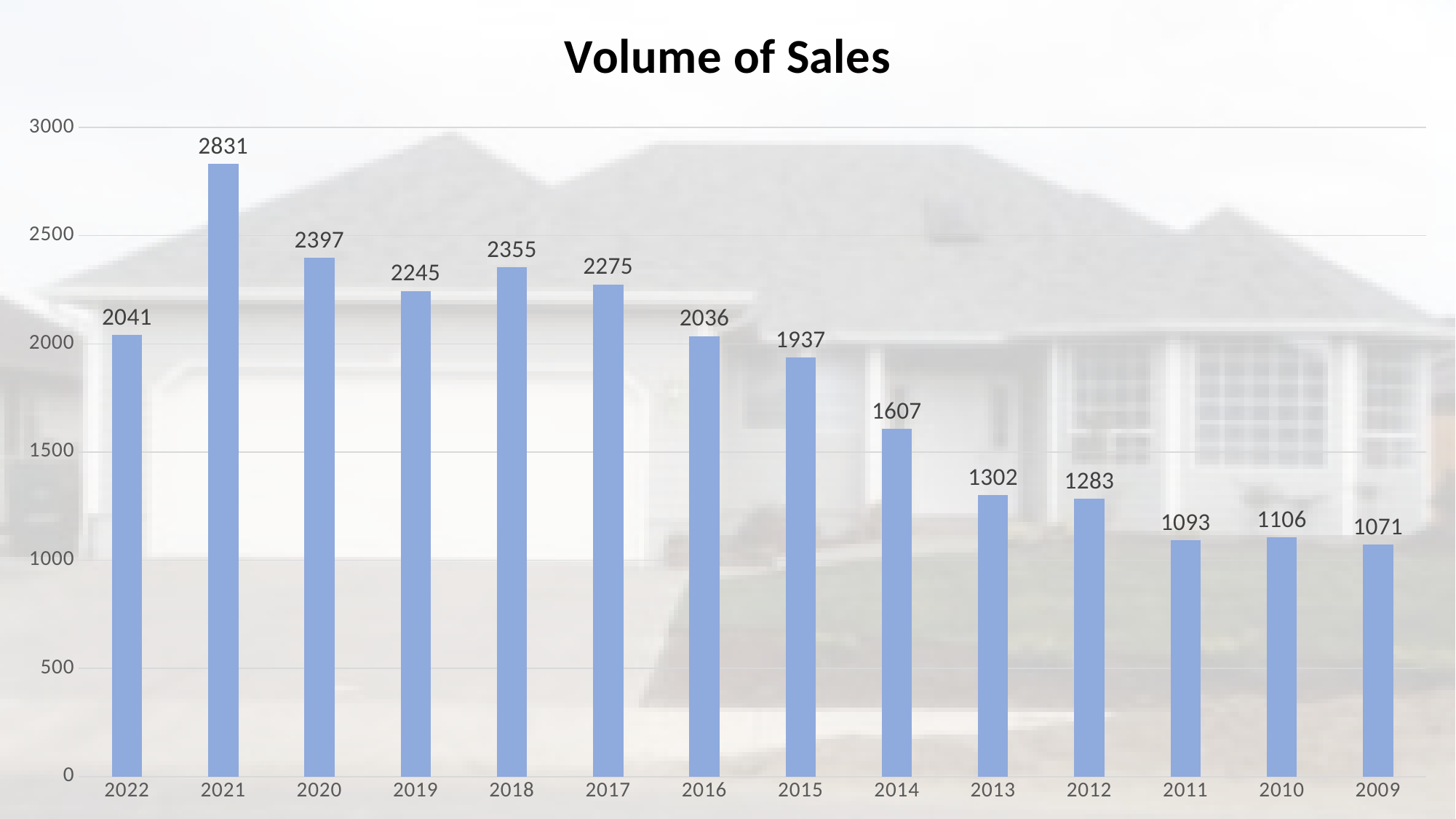
How many years are shown on the x axis? 14 What is the difference in volume of sales between 2020 and 2019? 152 Which year has a larger volume of sales, 2018 or 2017? 2018 What is the difference in volume of sales between 2021 and 2022? 790 What kind of chart is shown on the slide? Bar chart Which year has the lowest volume of sales? 2009 Which year has the highest volume of sales? 2021 What is the volume of sales for 2021? 2831 What is the volume of sales for 2009? 1071 What is the title of the chart? Volume of Sales What is the volume of sales for 2014? 1607 Is the value for 2015 greater or less than 2000? less